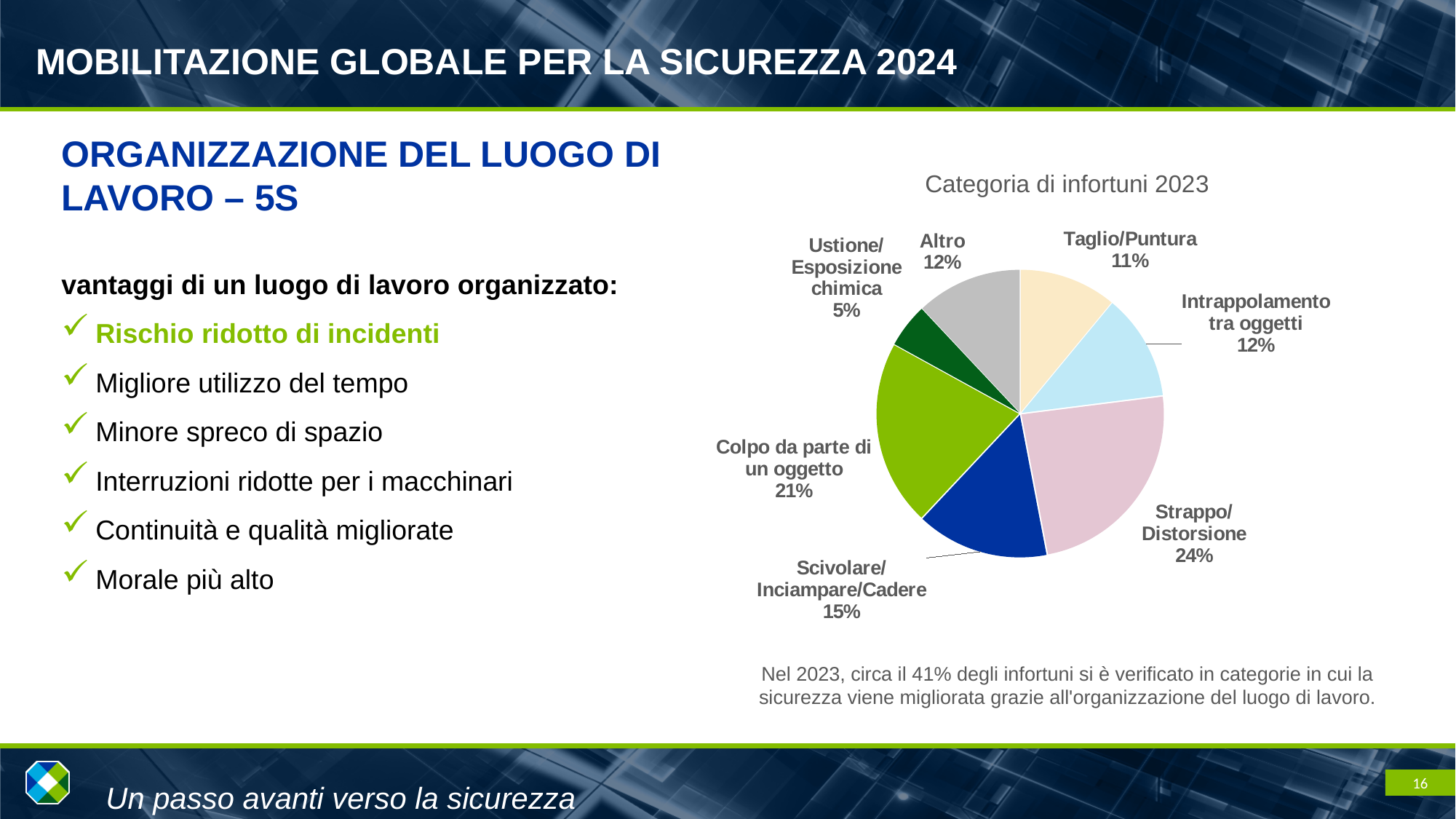
What type of chart is shown on the slide? Pie chart How many categories does the pie chart show? 7 What share of the pie is Strappo/Distorsione? 24% What is the value for Intrappolamento tra oggetti? 12% What is the title of the chart? Categoria di infortuni 2023 What is the value for Scivolare/Inciampare/Cadere? 15% Which category has the smallest share of the pie? Ustione/Esposizione chimica Which category has the largest share of the pie? Strappo/Distorsione Which is larger, the share for Colpo da parte di un oggetto or the share for Scivolare/Inciampare/Cadere? Colpo da parte di un oggetto What is the value for Colpo da parte di un oggetto? 21% What is the value for Ustione/Esposizione chimica? 5% What is the difference between the shares of Strappo/Distorsione and Taglio/Puntura? 13%